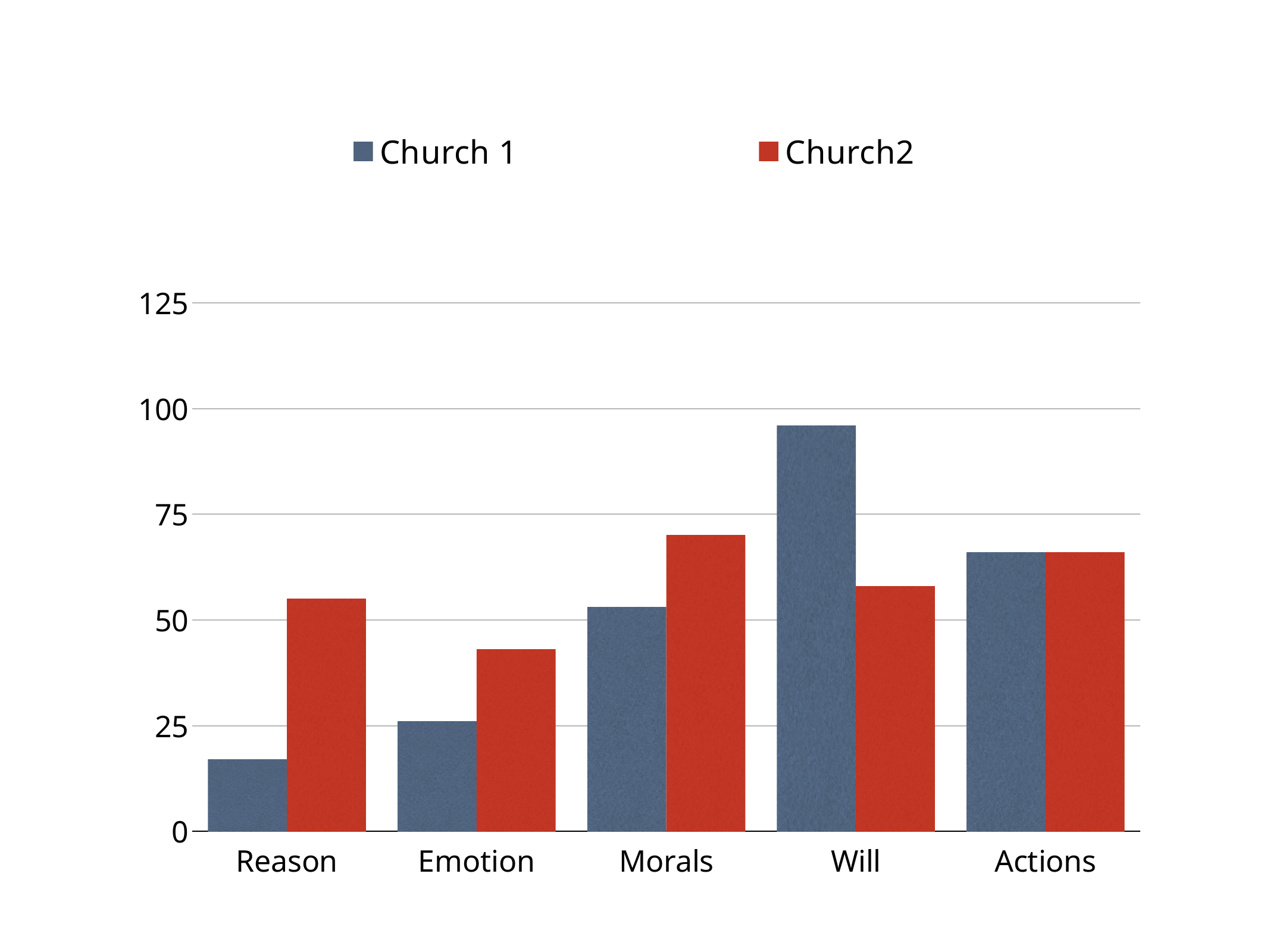
Is the value for Church2 in the Morals category greater or less than 75? less What colour are the bars for the Church2 series? red Is the value for Church 1 in the Will category greater or less than 75? greater How many categories are shown on the x axis? 5 Which category has the highest value for Church 1? Will What kind of chart is shown on the slide? bar chart How many series does the legend list? 2 Which category has the lowest value for Church2? Emotion Which category has the highest value for Church2? Morals Which category has the lowest value for Church 1? Reason For the Reason category, which series has the larger value, Church 1 or Church2? Church2 Is the value for Church 1 in the Reason category greater or less than 25? less